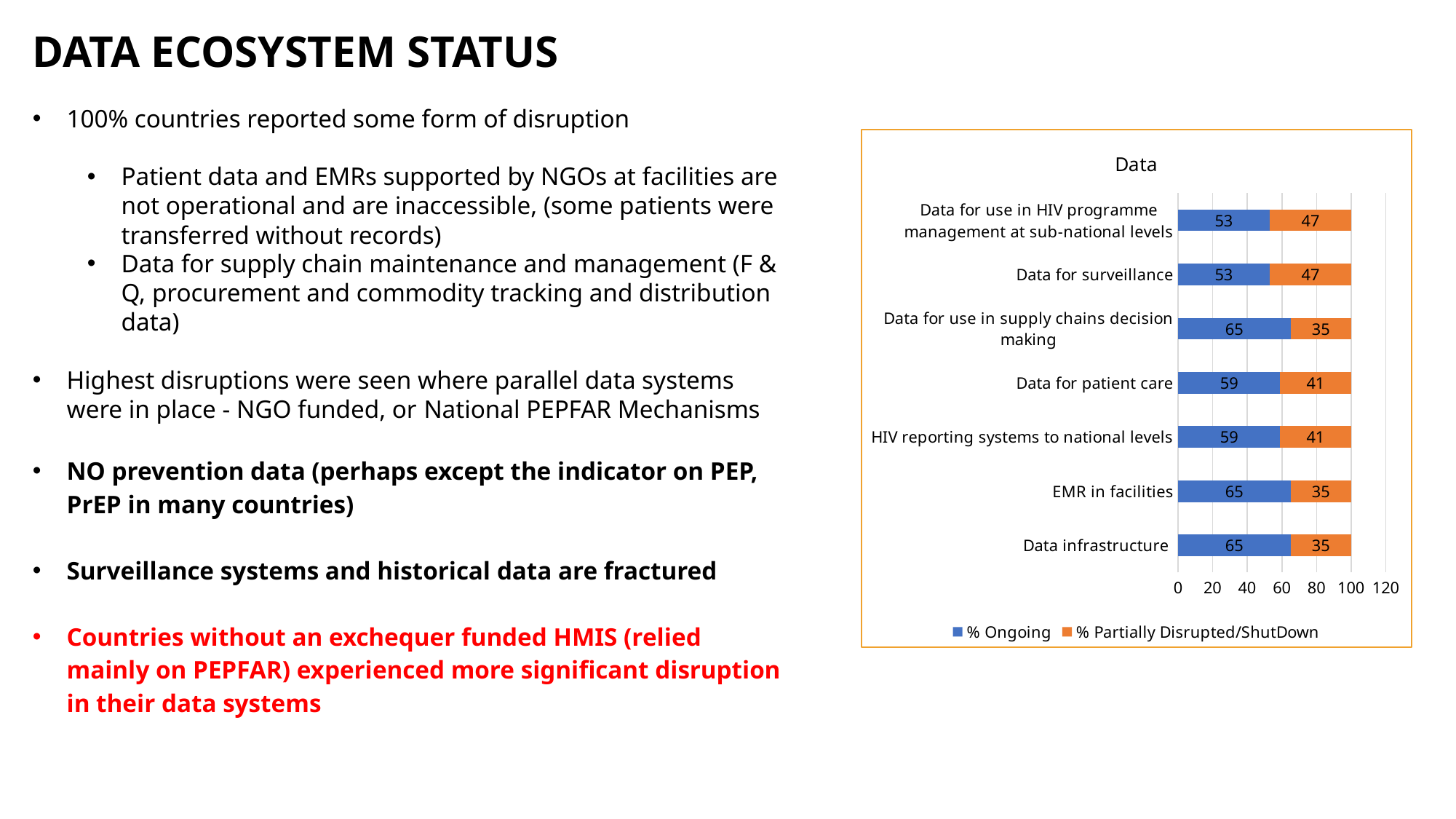
What is the total of the stacked bar for Data for use in supply chains decision making? 100 What is the % Partially Disrupted/ShutDown value for Data for surveillance? 47 What is the % Ongoing value for Data for patient care? 59 What is the % Partially Disrupted/ShutDown value for Data for use in HIV programme management at sub-national levels? 47 How many series does the legend list? 2 What is the title of the chart? Data What is the % Ongoing value for EMR in facilities? 65 Which category has the lowest % Ongoing value? Data for use in HIV programme management at sub-national levels and Data for surveillance (both 53) What kind of chart is shown on the slide? Stacked bar chart How many categories are shown in the chart? 7 Which is larger for HIV reporting systems to national levels: % Ongoing or % Partially Disrupted/ShutDown? % Ongoing What is the difference between the % Ongoing and % Partially Disrupted/ShutDown values for Data infrastructure? 30